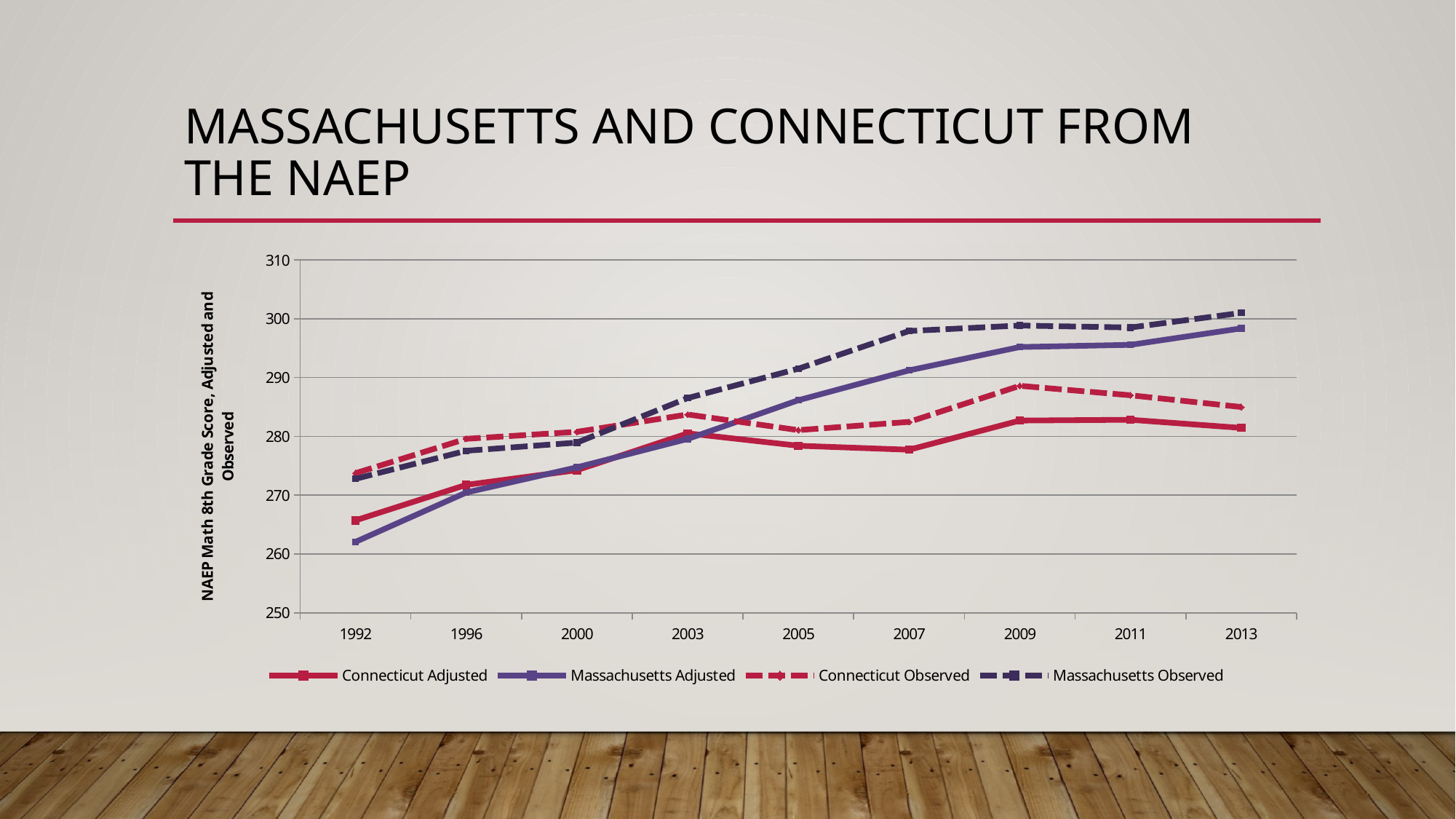
Is the value for Connecticut Adjusted in 1992 greater or less than 270? less Which series has the highest value in 2013? Massachusetts Observed Is the value for Connecticut Observed in 2009 greater or less than 280? greater What kind of chart is shown on the slide? line chart Is the value for Massachusetts Adjusted in 1992 greater or less than 270? less In 1992, which is higher: Connecticut Adjusted or Massachusetts Adjusted? Connecticut Adjusted In 2013, which is higher: Massachusetts Observed or Connecticut Observed? Massachusetts Observed Which series has the lowest value in 1992? Massachusetts Adjusted Does the Massachusetts Adjusted line generally rise or fall from 1992 to 2013? rise How many series does the legend list? 4 How many years are plotted along the x axis? 9